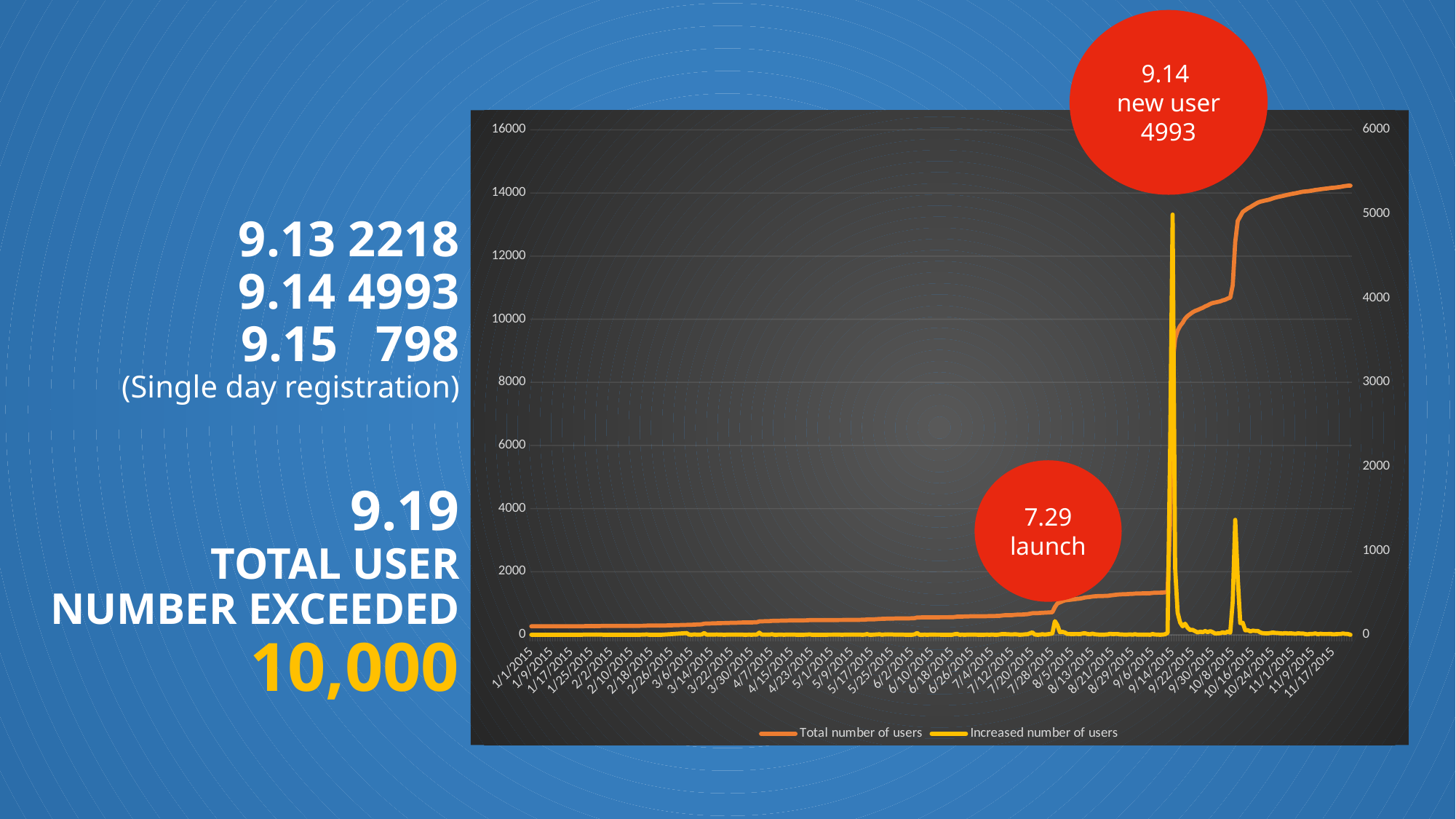
Is the Total number of users at 11/17/2015 greater or less than 12000? greater How many series does the chart legend list? 2 What is the highest value shown on the left vertical axis of the chart? 16000 According to the annotation on the chart, how many new users were registered on 9.14? 4993 What kind of chart is shown on the slide? line chart Is the Total number of users at 1/1/2015 greater or less than 2000? less What event does the red circle annotation at 7.29 mark? launch Does the Total number of users series rise or fall from 1/1/2015 to 11/17/2015? rise Is the peak of the Increased number of users series on 9/14/2015 greater or less than 4000 on the right axis? greater Which is larger: the Total number of users at 11/17/2015 or at 7/28/2015? 11/17/2015 What are the two series named in the chart legend? Total number of users; Increased number of users On which date does the Increased number of users series reach its highest peak? 9.14